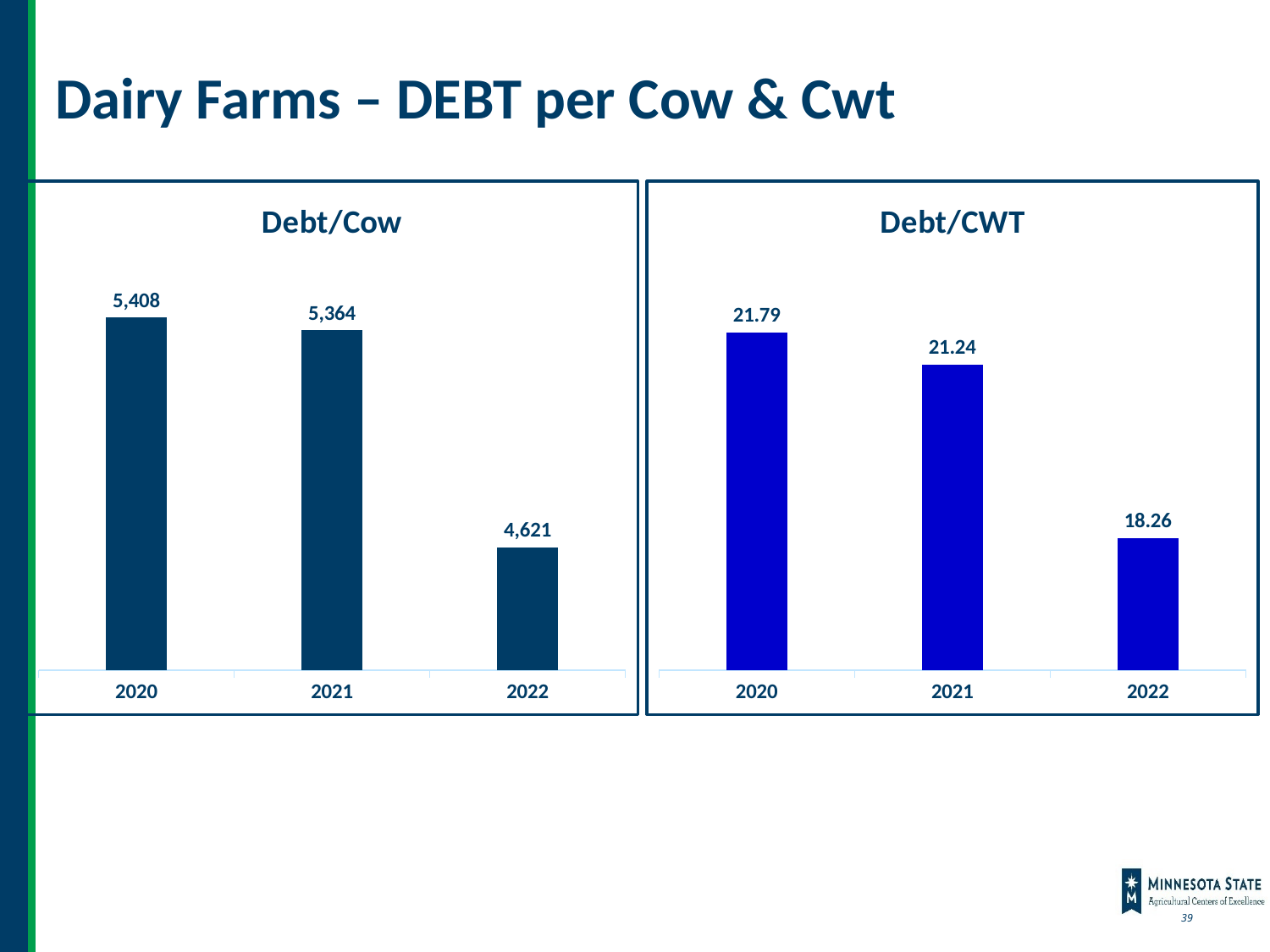
In the Debt/Cow chart, do the values rise or fall from 2020 to 2022? Fall In the Debt/Cow chart, what is the value for 2020? 5,408 In the Debt/CWT chart, what is the value for 2022? 18.26 In the Debt/CWT chart, what is the difference between the 2020 and 2022 values? 3.53 In the Debt/Cow chart, what is the value for 2022? 4,621 In the Debt/Cow chart, which year has the highest value? 2020 In the Debt/CWT chart, which year has the lowest value? 2022 What kind of chart is the Debt/CWT chart? Bar chart In the Debt/CWT chart, what is the value for 2021? 21.24 In the Debt/Cow chart, what is the difference between the 2021 and 2022 values? 743 How many years are shown in the Debt/Cow chart? 3 In the Debt/CWT chart, which is larger, the value for 2020 or the value for 2021? 2020